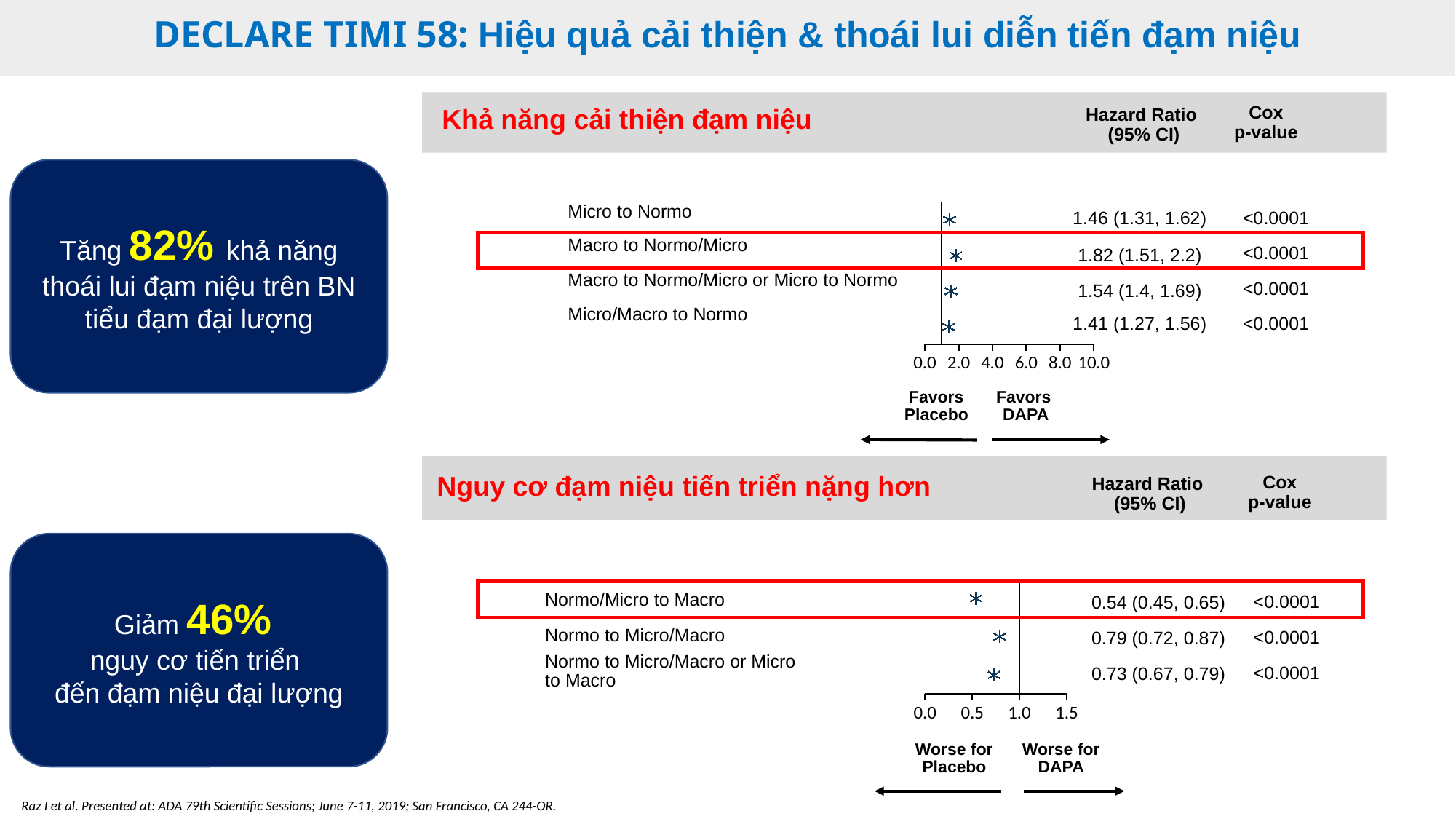
In the top chart (Khả năng cải thiện đạm niệu), which outcome has the highest hazard ratio? Macro to Normo/Micro In the bottom chart (Nguy cơ đạm niệu tiến triển nặng hơn), which outcome has the highest hazard ratio? Normo to Micro/Macro In the top chart (Khả năng cải thiện đạm niệu), what is the difference between the hazard ratios for Macro to Normo/Micro and Micro to Normo? 0.36 In the bottom chart (Nguy cơ đạm niệu tiến triển nặng hơn), how many outcomes are plotted? 3 In the top chart (Khả năng cải thiện đạm niệu), what is the 95% CI for Micro to Normo? (1.31, 1.62) In the bottom chart (Nguy cơ đạm niệu tiến triển nặng hơn), what does the right-pointing arrow below the axis indicate? Worse for DAPA In the top chart (Khả năng cải thiện đạm niệu), which outcome has the lowest hazard ratio? Micro/Macro to Normo In the bottom chart (Nguy cơ đạm niệu tiến triển nặng hơn), is the hazard ratio for Normo to Micro/Macro or Micro to Macro greater or less than 1.0? less In the top chart (Khả năng cải thiện đạm niệu), how many outcomes are plotted? 4 In the bottom chart (Nguy cơ đạm niệu tiến triển nặng hơn), what is the hazard ratio for Normo/Micro to Macro? 0.54 In the top chart (Khả năng cải thiện đạm niệu), what is the hazard ratio for Macro to Normo/Micro? 1.82 In the bottom chart (Nguy cơ đạm niệu tiến triển nặng hơn), what is the Cox p-value for Normo to Micro/Macro? <0.0001